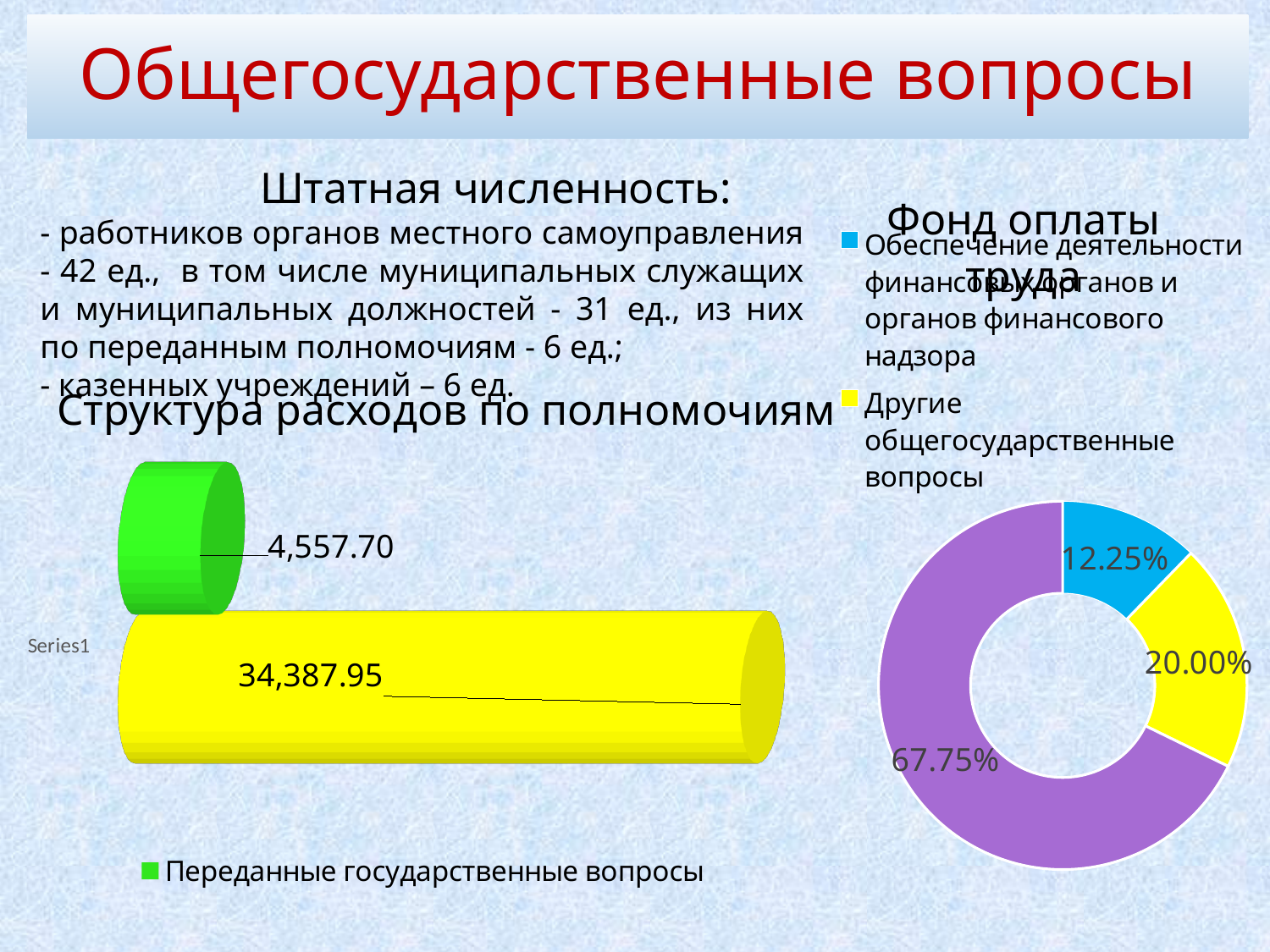
On the doughnut chart titled 'Фонд оплаты труда', what share is shown for 'Обеспечение деятельности финансовых органов и органов финансового надзора'? 12.25% On the chart titled 'Структура расходов по полномочиям', how many bars are plotted? 2 On the chart titled 'Структура расходов по полномочиям', what is the value of the green bar labelled 'Переданные государственные вопросы'? 4,557.70 On the chart titled 'Структура расходов по полномочиям', which bar has the larger value, the green one or the yellow one? the yellow one What kind of chart is the one titled 'Структура расходов по полномочиям'? bar chart On the doughnut chart titled 'Фонд оплаты труда', what is the share of the largest (purple) slice? 67.75% On the doughnut chart titled 'Фонд оплаты труда', how many slices are there? 3 On the doughnut chart titled 'Фонд оплаты труда', which slice is the smallest? Обеспечение деятельности финансовых органов и органов финансового надзора On the chart titled 'Структура расходов по полномочиям', what is the value of the yellow bar? 34,387.95 On the chart titled 'Структура расходов по полномочиям', what is the difference between the yellow bar value and the green bar value? 29,830.25 On the doughnut chart titled 'Фонд оплаты труда', what is the difference between the 20.00% slice and the 12.25% slice? 7.75% On the doughnut chart titled 'Фонд оплаты труда', what share is shown for 'Другие общегосударственные вопросы'? 20.00%